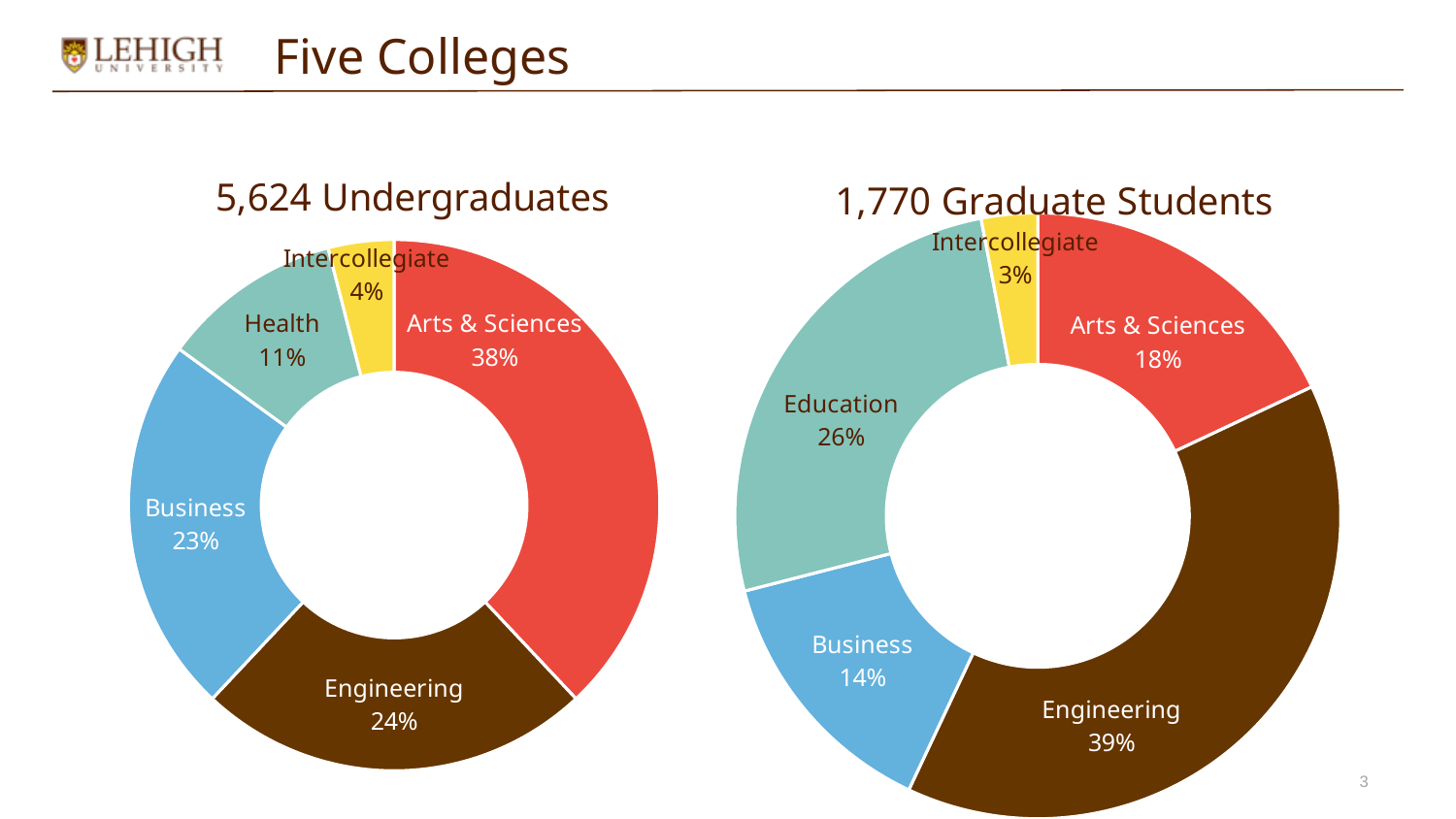
In the '5,624 Undergraduates' chart, what share is Intercollegiate? 4% In the '5,624 Undergraduates' chart, what share is Arts & Sciences? 38% What colour is the Engineering slice in both charts? Dark brown What kind of chart is the '1,770 Graduate Students' chart? Doughnut chart In the '1,770 Graduate Students' chart, what share is Engineering? 39% In the '5,624 Undergraduates' chart, which college has the largest share? Arts & Sciences In the '1,770 Graduate Students' chart, which is larger, Education or Arts & Sciences? Education How many slices does the '5,624 Undergraduates' chart have? 5 In the '5,624 Undergraduates' chart, what is the difference between the Business and Health shares? 12% In the '1,770 Graduate Students' chart, what share is Business? 14% In the '1,770 Graduate Students' chart, which college has the smallest share? Intercollegiate In the '1,770 Graduate Students' chart, what is the difference between the Engineering and Arts & Sciences shares? 21%